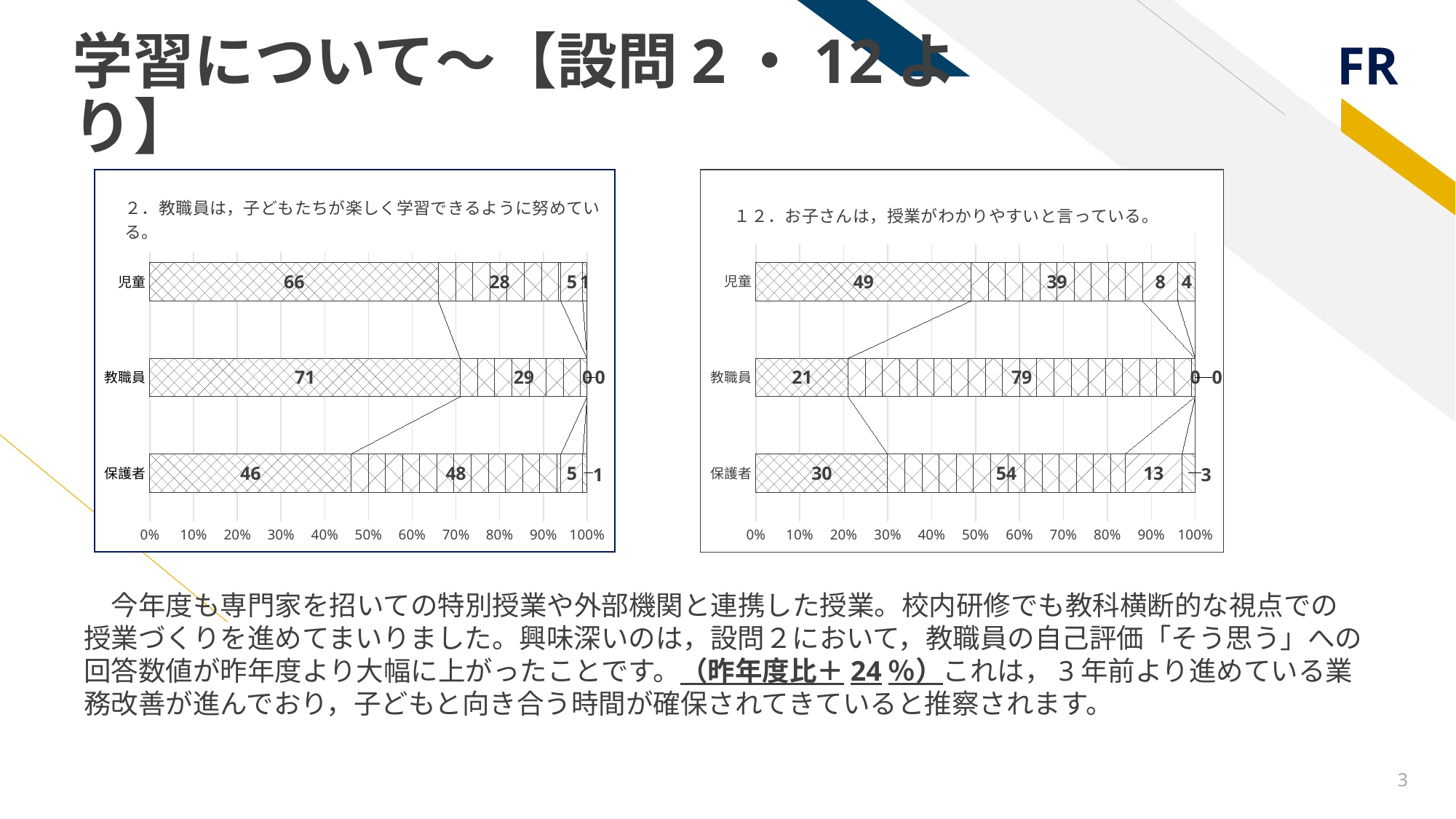
In the right chart (設問12), what is the value of the second segment for 教職員? 79 What type of chart is the right chart (設問12)? Stacked bar chart In the left chart (設問2), what is the value of the second segment for 保護者? 48 In the right chart (設問12), what is the value of the third segment for 保護者? 13 In the left chart (設問2), which category has the highest value in the first (leftmost) segment? 教職員 In the right chart (設問12), which category has the lowest value in the first (leftmost) segment? 教職員 What is the title of the left chart? ２．教職員は，子どもたちが楽しく学習できるように努めている。 In the right chart (設問12), which is larger: the first-segment value for 児童 or for 保護者? 児童 In the left chart (設問2), what is the difference between the first-segment values for 教職員 and 保護者? 25 In the right chart (設問12), what is the value of the first (leftmost) segment for 児童? 49 In the left chart (設問2), what is the value of the first (leftmost) segment for 教職員? 71 How many categories are shown on the y axis of the left chart (設問2)? 3